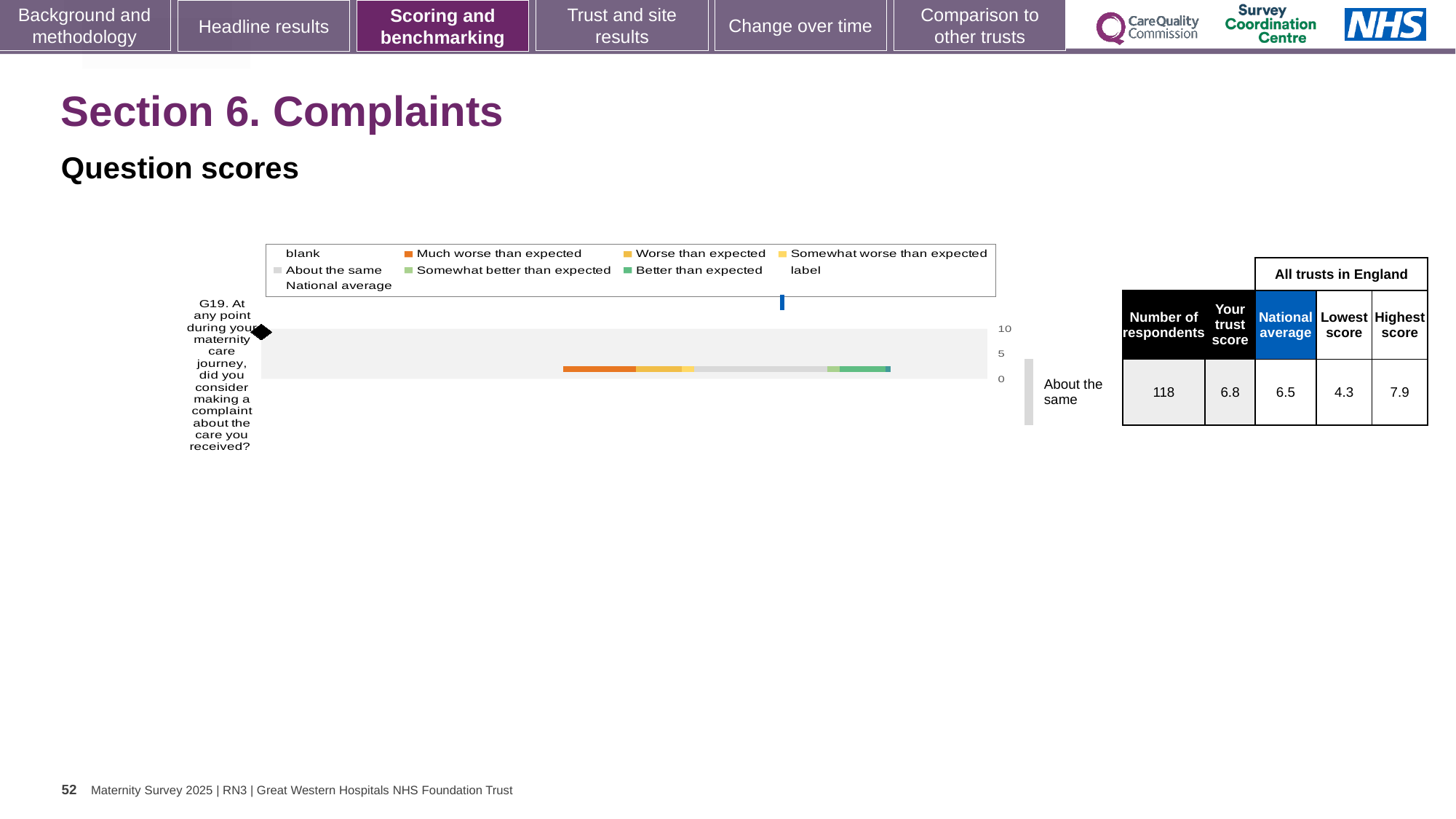
What is the difference between the highest and lowest scores for question G19? 3.6 What is the trust score for question G19? 6.8 How many respondents answered question G19? 118 Which question number is plotted on the chart? G19 What kind of chart is shown on the slide? bar chart Which is larger for question G19, the trust score or the national average? the trust score How many survey questions are plotted on the chart? 1 What is the highest score among all trusts in England for question G19? 7.9 What is the lowest score among all trusts in England for question G19? 4.3 What is the highest value shown on the chart's score axis? 10 Is the trust score for question G19 greater or less than 5? greater What is the national average score for question G19? 6.5